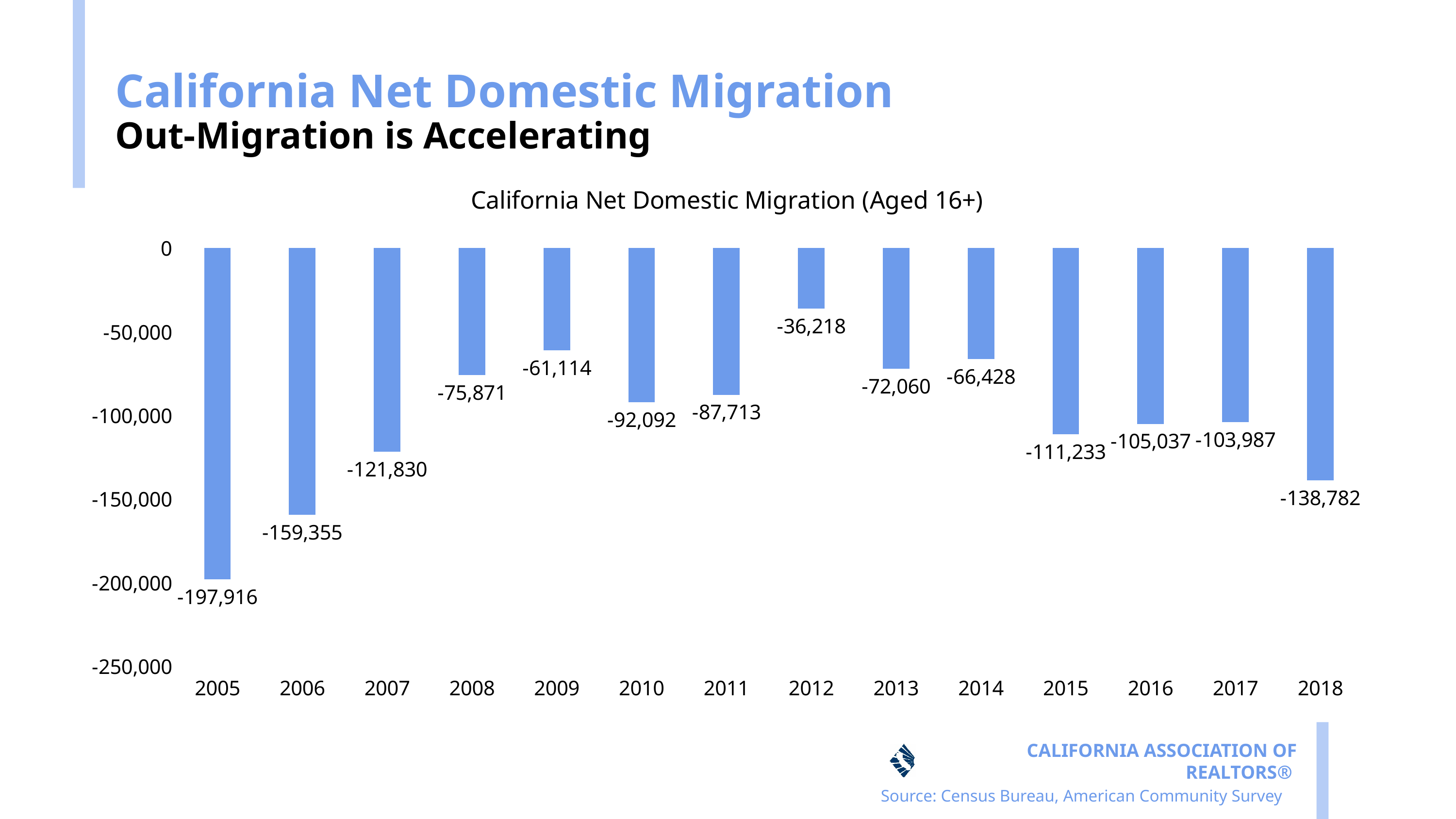
What kind of chart is shown on the slide? Bar chart What is the difference between the values for 2005 and 2006? 38,561 What is the net domestic migration value shown for 2018? -138,782 What is the value shown for 2015? -111,233 What value is labelled on the bar for 2012? -36,218 By how much does the value for 2018 differ from the value for 2017? 34,795 What is the net domestic migration value shown for 2005? -197,916 How many years are plotted on the chart? 14 Which year has the value closest to zero (the smallest net out-migration)? 2012 Which year has the most negative value (the largest net out-migration)? 2005 Which year has a more negative value, 2010 or 2011? 2010 From 2012 to 2018, do the values rise or fall? Fall